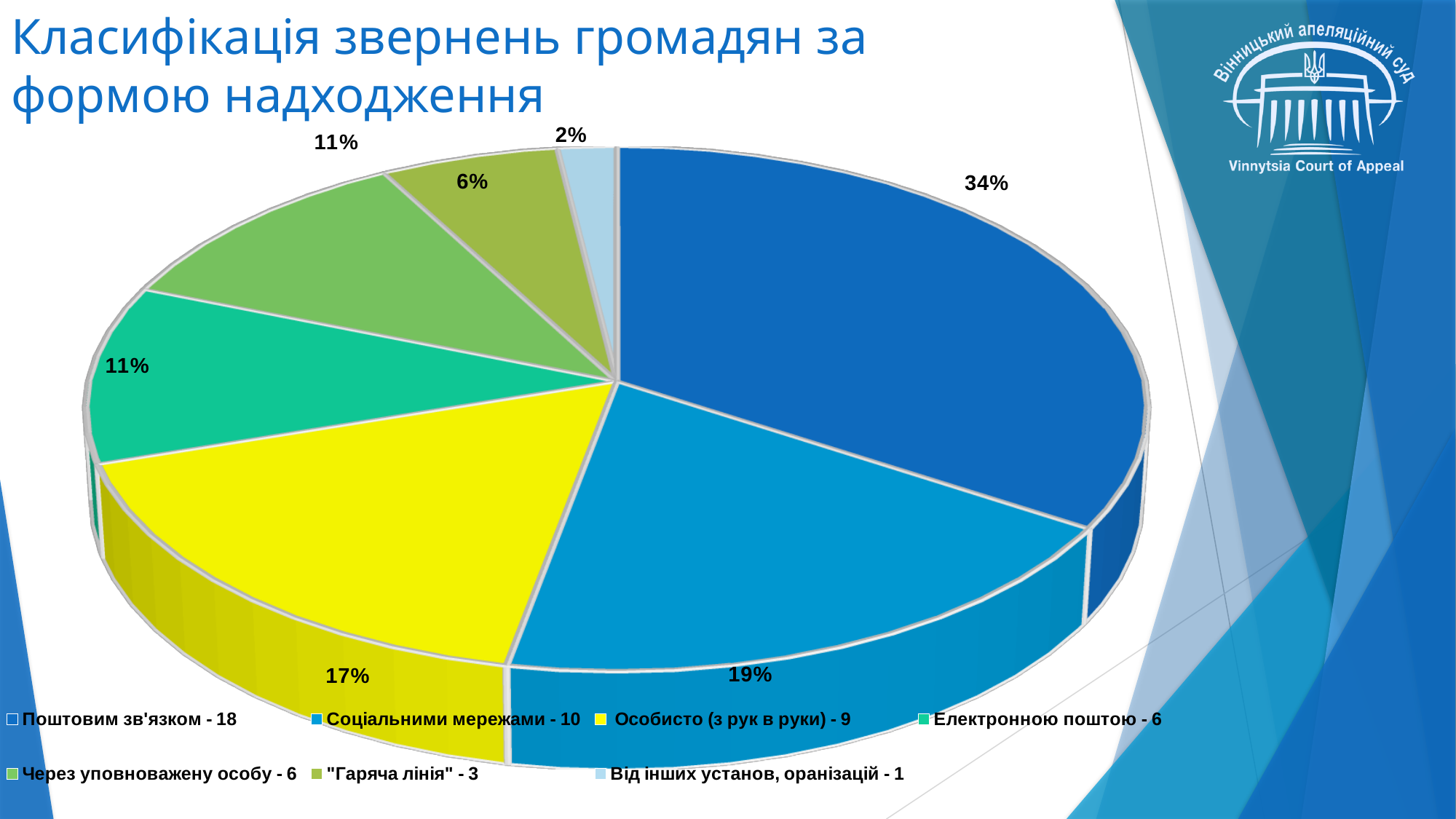
What percentage share is shown for the slice "Гаряча лінія"? 6% Which category has the largest slice of the pie? Поштовим зв'язком What percentage share is shown for the slice "Особисто (з рук в руки)"? 17% What is the difference in percentage points between the "Поштовим зв'язком" slice and the "Соціальними мережами" slice? 15% What percentage share is shown for the slice "Соціальними мережами"? 19% Which category has the smallest slice of the pie? Від інших установ, оранізацій Which slice is larger: "Особисто (з рук в руки)" or "Гаряча лінія"? Особисто (з рук в руки) According to the legend, how many appeals were received via "Електронною поштою"? 6 How many slices does the pie chart have? 7 According to the legend, how many appeals were received via "Соціальними мережами"? 10 What kind of chart is shown on the slide? pie chart